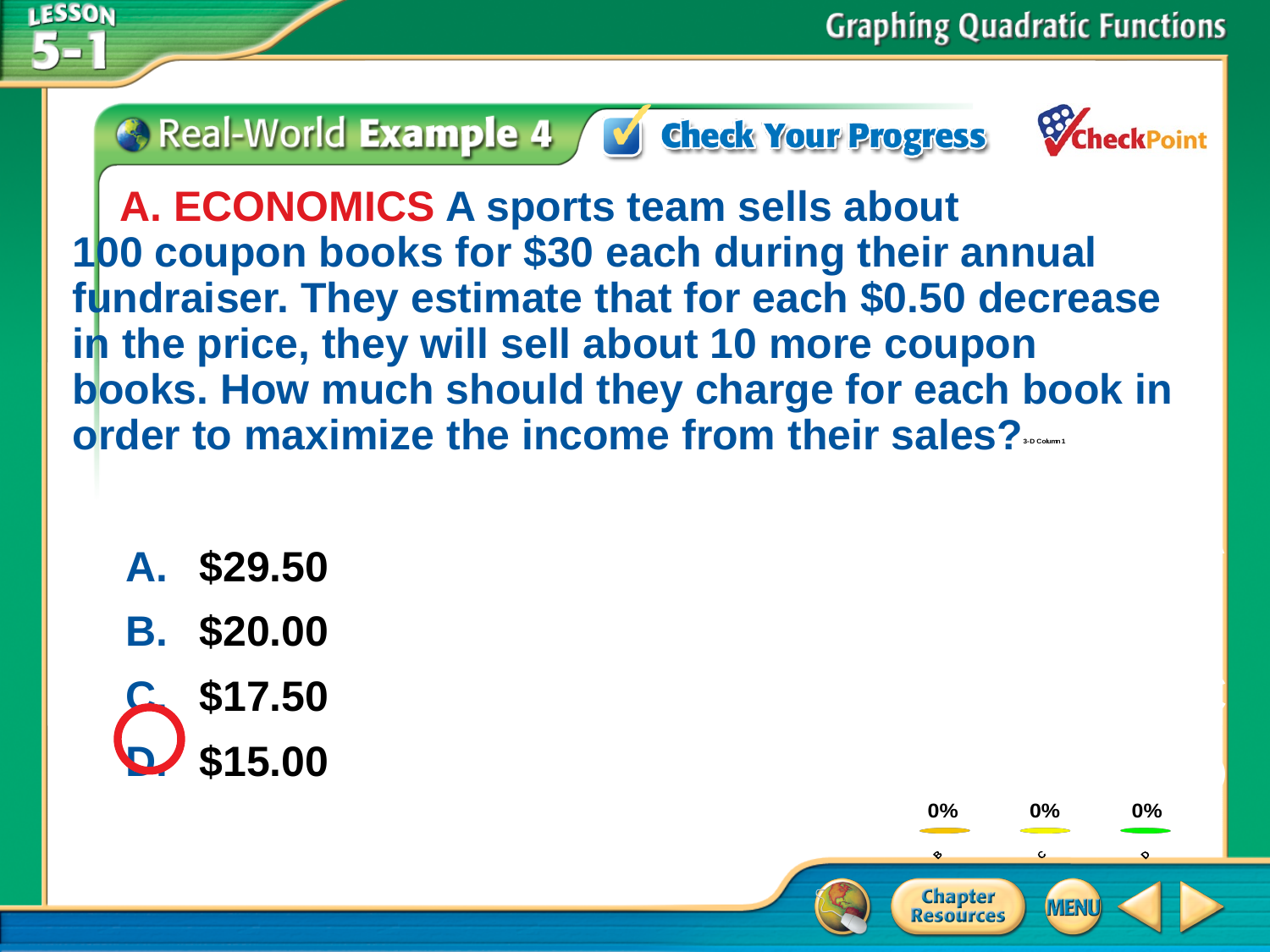
What kind of chart is shown at the bottom right of the slide? bar chart In the chart at the bottom right of the slide, do all three bars show the same value? yes What value is labelled above the middle bar in the chart at the bottom right of the slide? 0% In the chart at the bottom right of the slide, what is the difference between the values of the leftmost and rightmost bars? 0% What is the total of the three values labelled in the chart at the bottom right of the slide? 0% How many bars are shown in the small chart at the bottom right of the slide? 3 What value is labelled above the rightmost bar in the chart at the bottom right of the slide? 0% What value is labelled above the leftmost bar in the chart at the bottom right of the slide? 0%